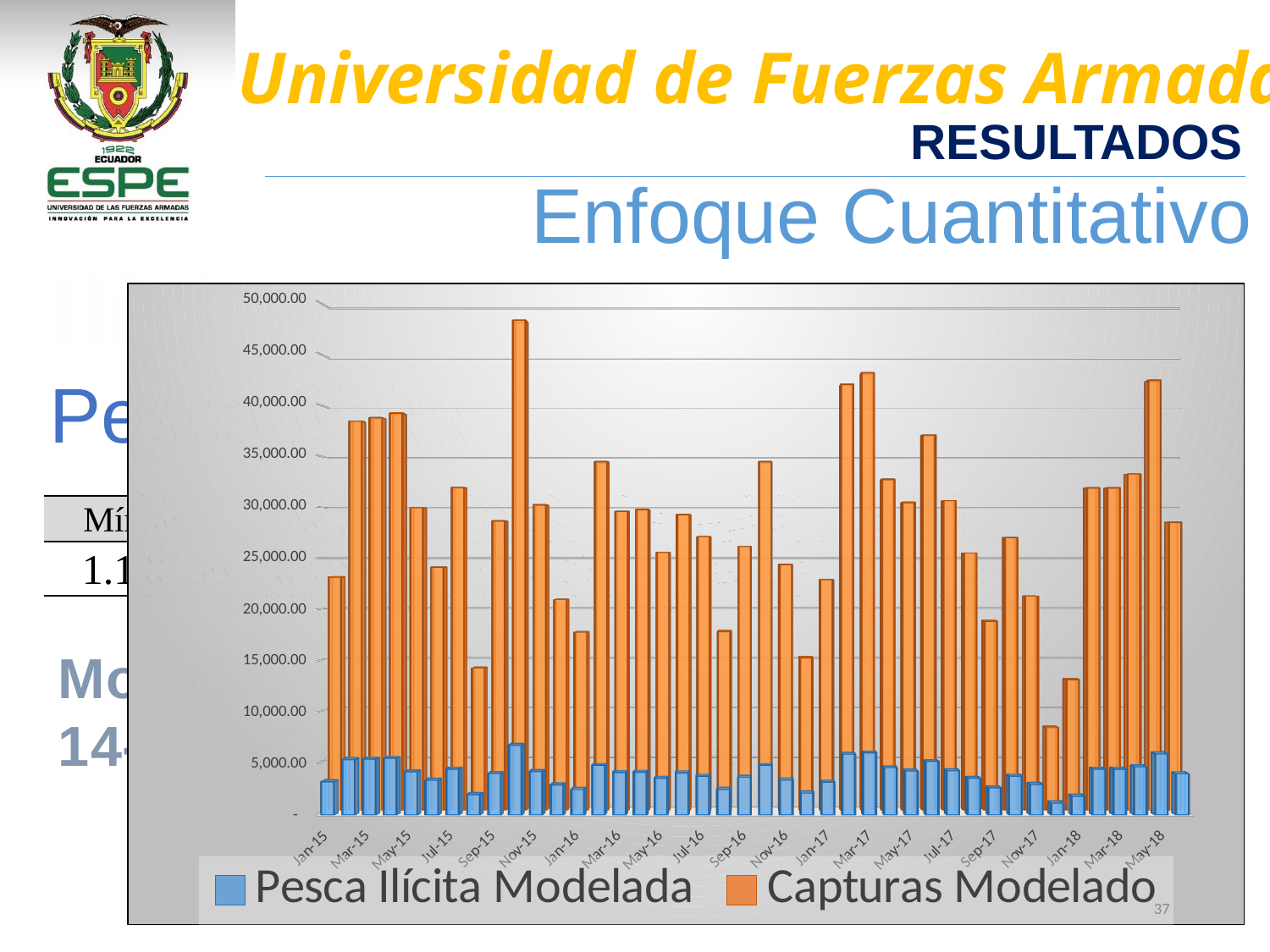
Is the value for Capturas Modelado in Jan-15 greater or less than 20,000.00? greater What are the two series named in the chart legend? Pesca Ilícita Modelada and Capturas Modelado Is the value for Capturas Modelado in Jan-15 greater or less than 25,000.00? less Is the value for Capturas Modelado in Mar-15 greater or less than 35,000.00? greater In Jan-15, which series has the larger value, Pesca Ilícita Modelada or Capturas Modelado? Capturas Modelado How many series does the chart legend list? 2 Which colour represents the Capturas Modelado series? orange What kind of chart is shown on the slide? bar chart For Capturas Modelado, which is larger, the value in Jan-15 or the value in Mar-15? Mar-15